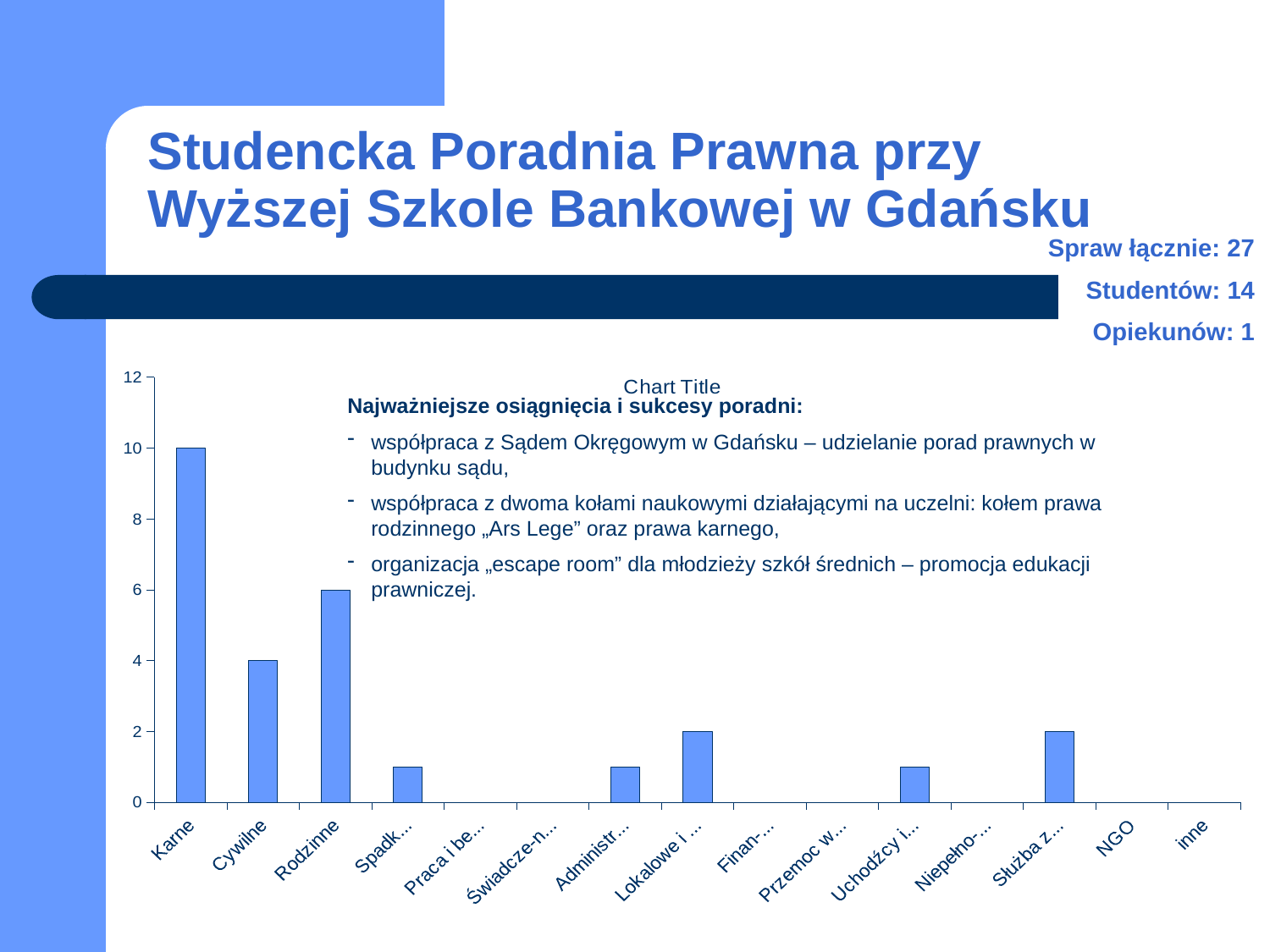
What is the difference between the values for Karne and Rodzinne? 4 What is the title shown above the chart? Chart Title Which category has the highest value? Karne What is the value for Cywilne? 4 What kind of chart is shown on the slide? bar chart How many categories are shown on the x axis of the chart? 15 Is the value for Cywilne greater or less than 6? less What is the value for Karne? 10 What is the value for Rodzinne? 6 Is the value for Karne greater or less than 8? greater Which is larger, the value for Cywilne or the value for Rodzinne? Rodzinne What is the difference between the values for Rodzinne and Cywilne? 2